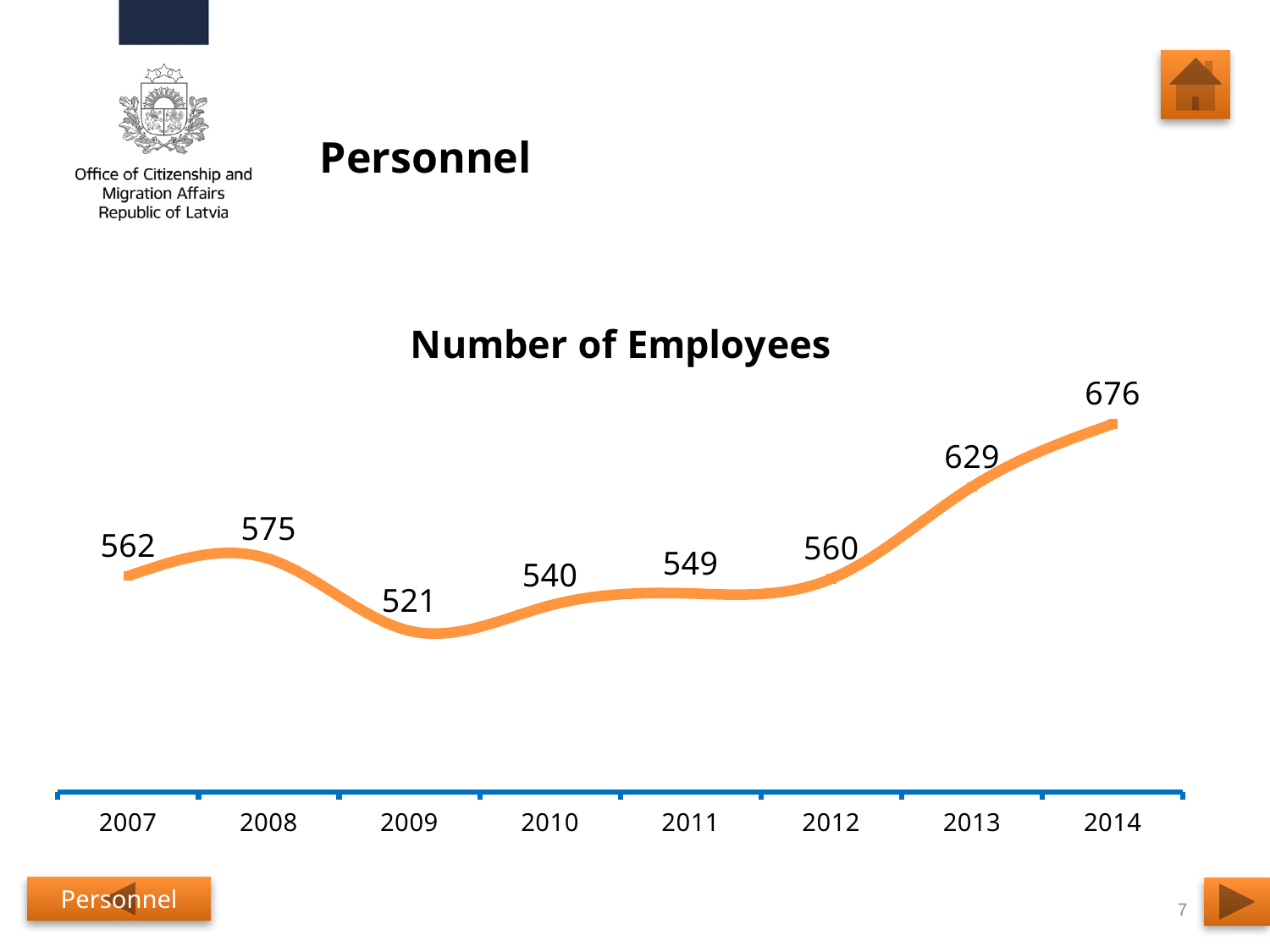
What is the number of employees in 2009? 521 What is the title of the chart? Number of Employees What is the difference in the number of employees between 2008 and 2009? 54 Which year has the lowest number of employees? 2009 Does the number of employees rise or fall from 2011 to 2014? Rise What kind of chart is shown on the slide? Line chart What is the difference in the number of employees between 2014 and 2013? 47 What is the number of employees in 2014? 676 How many years are shown on the x axis of the chart? 8 What is the number of employees in 2011? 549 Which year has the highest number of employees? 2014 Which year has more employees, 2007 or 2012? 2007